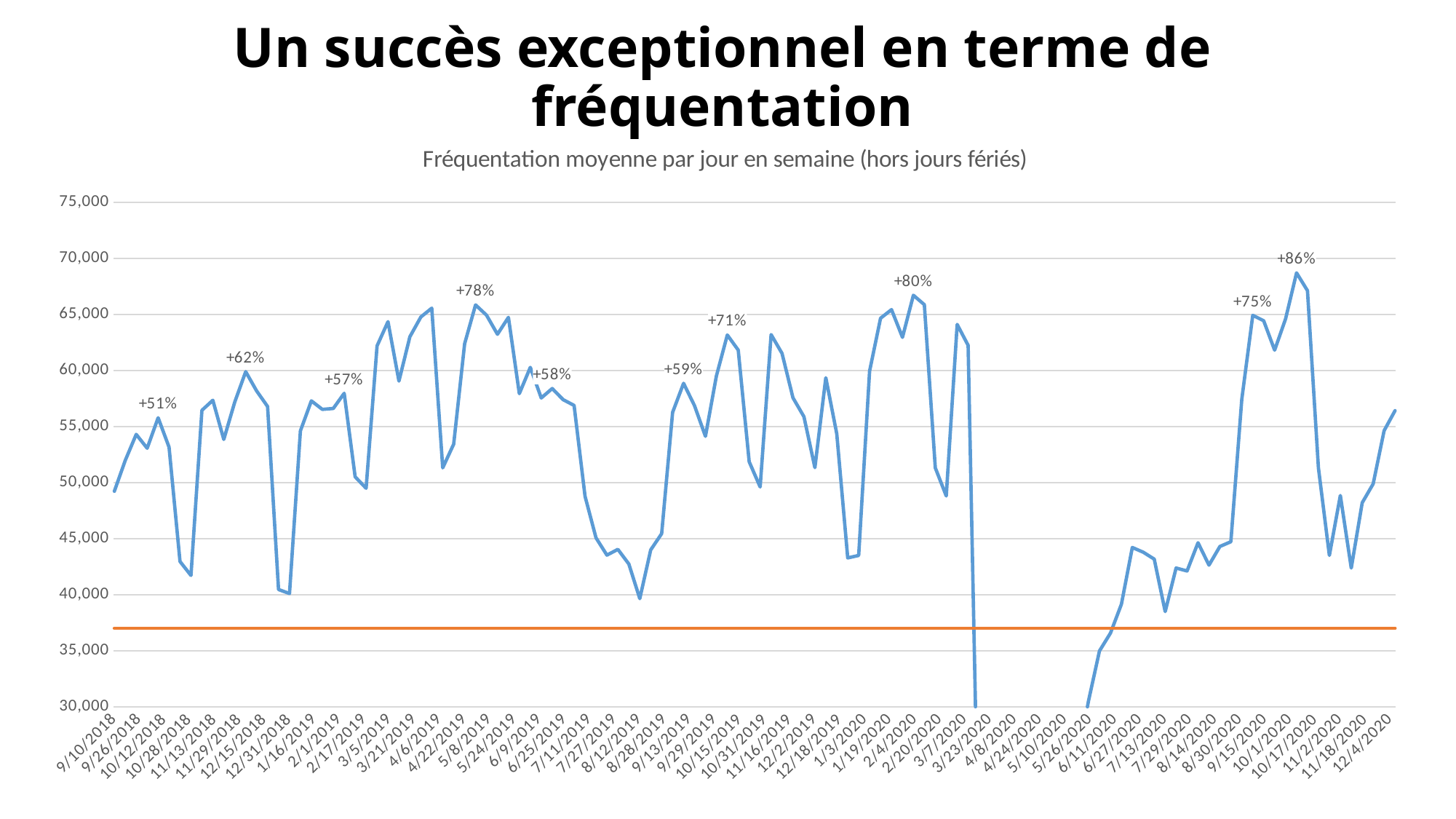
What is the highest percentage label printed on the chart? +86% Is the orange horizontal line above or below 40,000? below What is the title of the chart? Fréquentation moyenne par jour en semaine (hors jours fériés) Is the value at 12/4/2020 greater or less than 55,000? greater What percentage label is printed near the peak around 2/4/2020? +80% What percentage label is printed near the peak around 5/8/2019? +78% How many percentage data labels are printed on the chart? 10 What is the highest value shown on the vertical axis? 75,000 Does the blue line rise or fall between 10/17/2020 and 11/2/2020? fall What is the lowest percentage label printed on the chart? +51% What kind of chart is shown on the slide? line chart Is the value at 3/23/2020 greater or less than 35,000? less